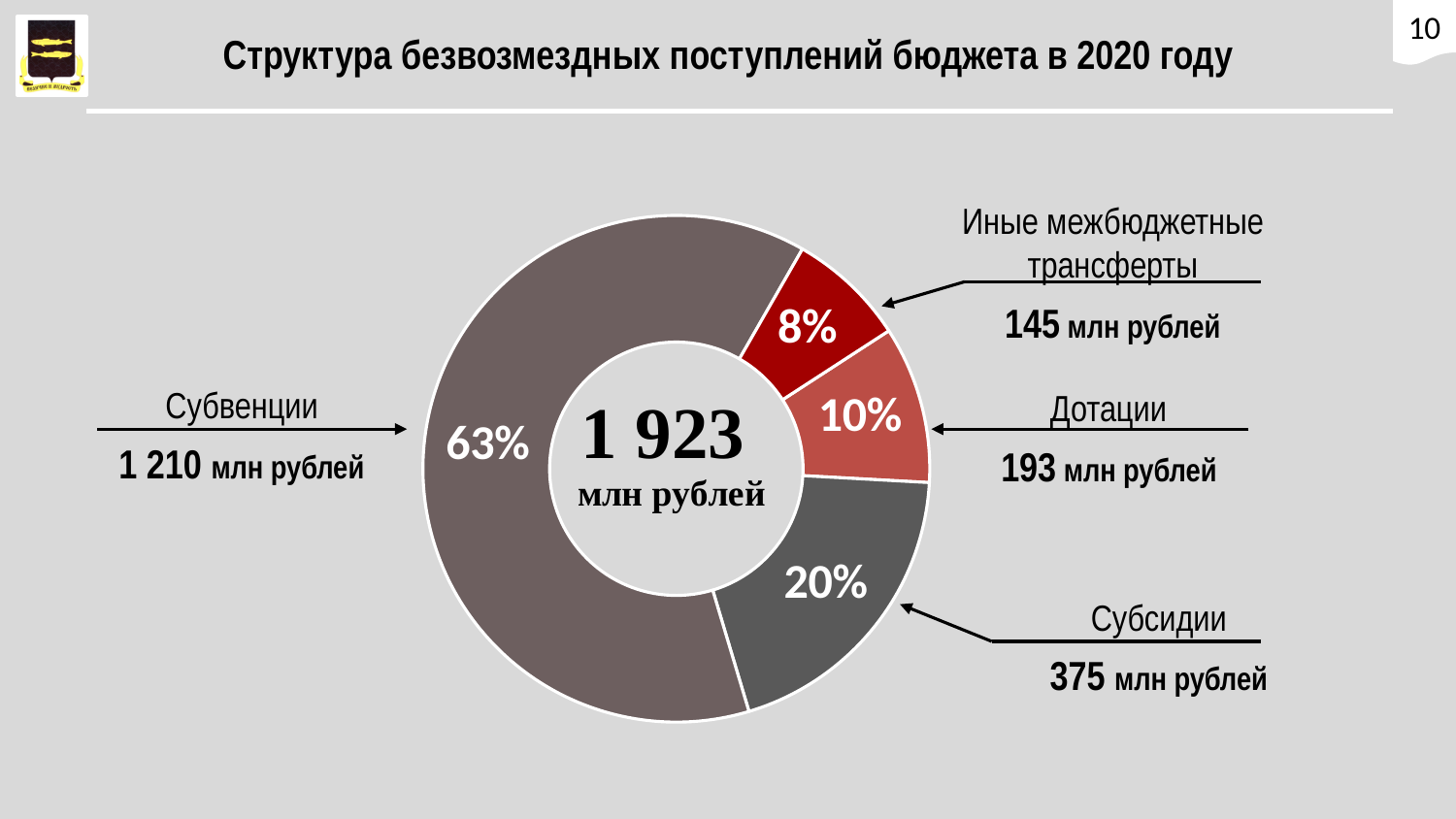
What is the value for Субвенции? 1 210 млн рублей What share of the chart does Субсидии represent? 20% What type of chart is shown on the slide? Pie chart (donut) What is the value for Иные межбюджетные трансферты? 145 млн рублей Which category has the smallest share of the chart? Иные межбюджетные трансферты How many categories are shown in the chart? 4 What is the value for Дотации? 193 млн рублей What total value is shown in the centre of the chart? 1 923 млн рублей What is the difference between the values for Субсидии and Дотации, in млн рублей? 182 What share of the chart does Субвенции represent? 63% Which category has the largest share of the chart? Субвенции Which is larger, the value for Дотации or the value for Иные межбюджетные трансферты? Дотации